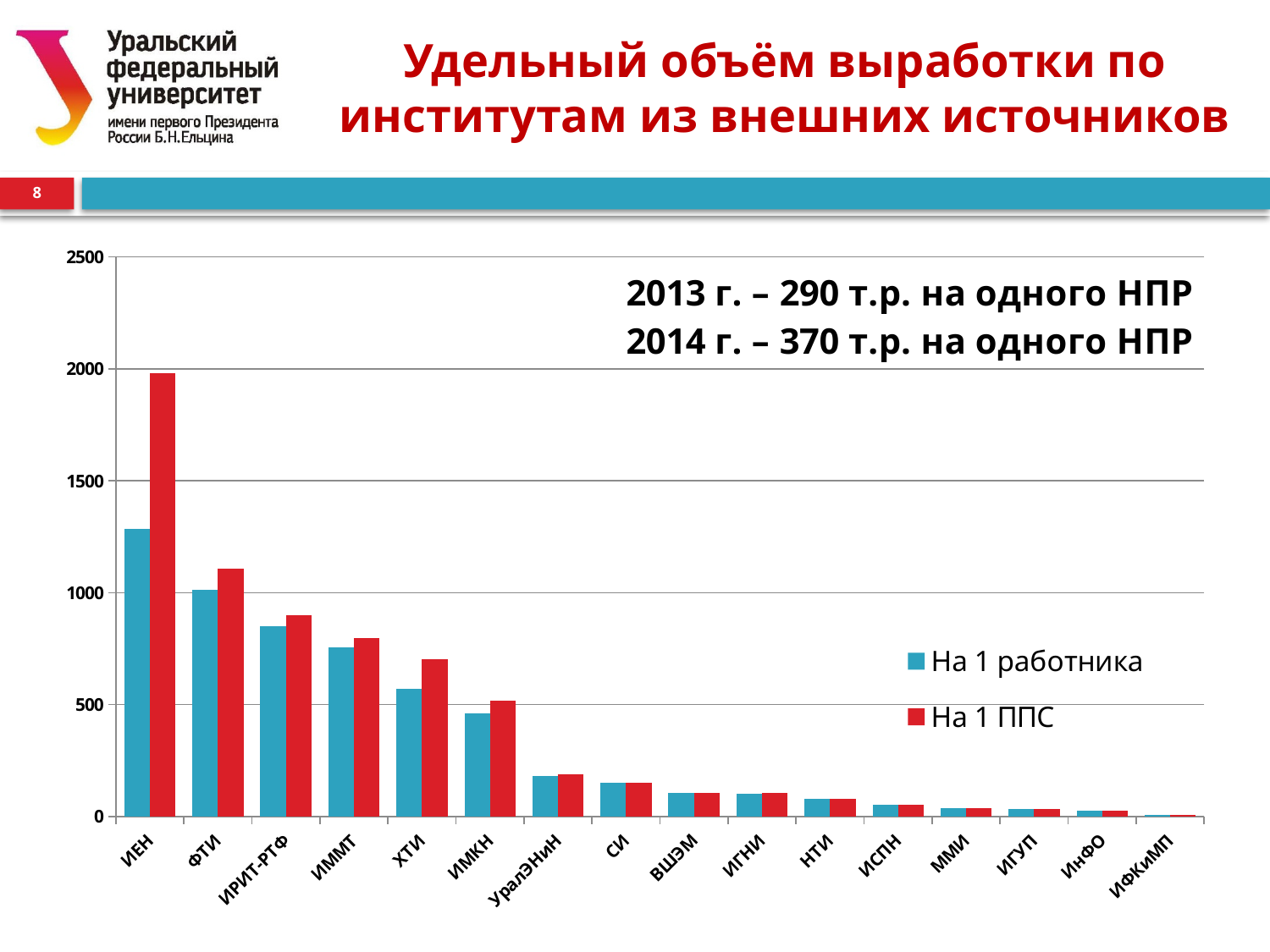
What kind of chart is shown on the slide? bar chart Which is larger for ИЕН: the 'На 1 работника' value or the 'На 1 ППС' value? На 1 ППС Which institute has the highest value for 'На 1 ППС'? ИЕН Which institute has the lowest value for 'На 1 работника'? ИФКиМП Which institute has the larger 'На 1 работника' value, ИММТ or ИМКН? ИММТ Which colour represents the 'На 1 ППС' series in the legend? red How many institutes (categories) are shown on the x axis? 16 Is the 'На 1 ППС' value for ИЕН greater or less than 1500? greater How many series does the legend list? 2 Is the 'На 1 ППС' value for ФТИ greater or less than 1000? greater Do the values generally rise or fall moving from left to right along the x axis? fall Is the 'На 1 работника' value for ХТИ greater or less than 1000? less